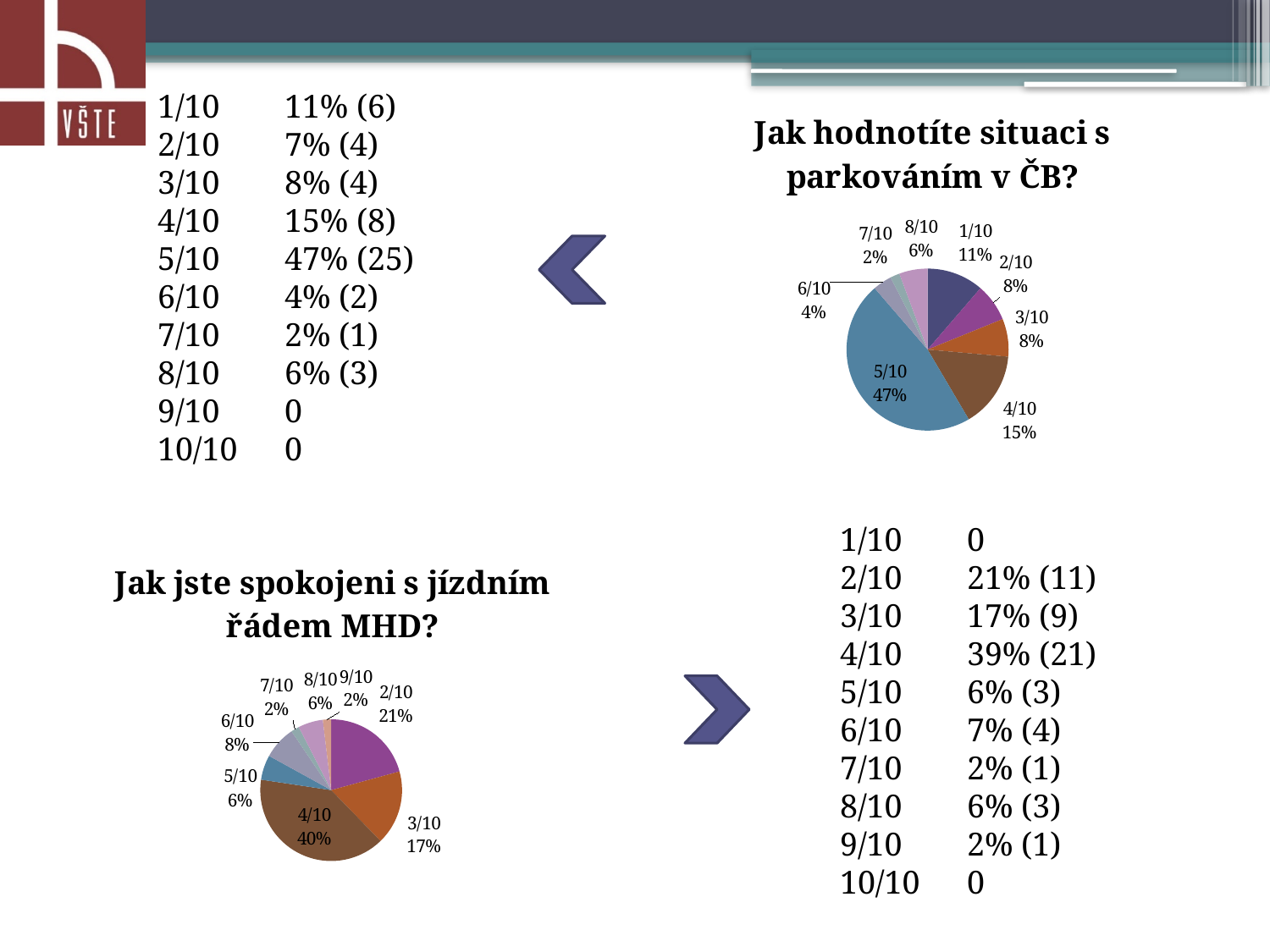
In the chart titled "Jak jste spokojeni s jízdním řádem MHD?", which category has the largest slice? 4/10 In the chart titled "Jak hodnotíte situaci s parkováním v ČB?", what share is labelled for 5/10? 47% In the chart titled "Jak jste spokojeni s jízdním řádem MHD?", which is larger, the share for 3/10 or the share for 6/10? 3/10 In the chart titled "Jak jste spokojeni s jízdním řádem MHD?", how many slices does the pie have? 8 In the chart titled "Jak jste spokojeni s jízdním řádem MHD?", what share is labelled for 2/10? 21% In the chart titled "Jak hodnotíte situaci s parkováním v ČB?", what share is labelled for 4/10? 15% In the chart titled "Jak jste spokojeni s jízdním řádem MHD?", what share is labelled for 4/10? 40% In the chart titled "Jak hodnotíte situaci s parkováním v ČB?", what is the difference between the shares for 5/10 and 4/10? 32% In the chart titled "Jak hodnotíte situaci s parkováním v ČB?", which category has the smallest slice? 7/10 In the chart titled "Jak hodnotíte situaci s parkováním v ČB?", how many slices does the pie have? 8 What kind of chart is used for "Jak hodnotíte situaci s parkováním v ČB?"? pie chart In the chart titled "Jak hodnotíte situaci s parkováním v ČB?", which category has the largest slice? 5/10